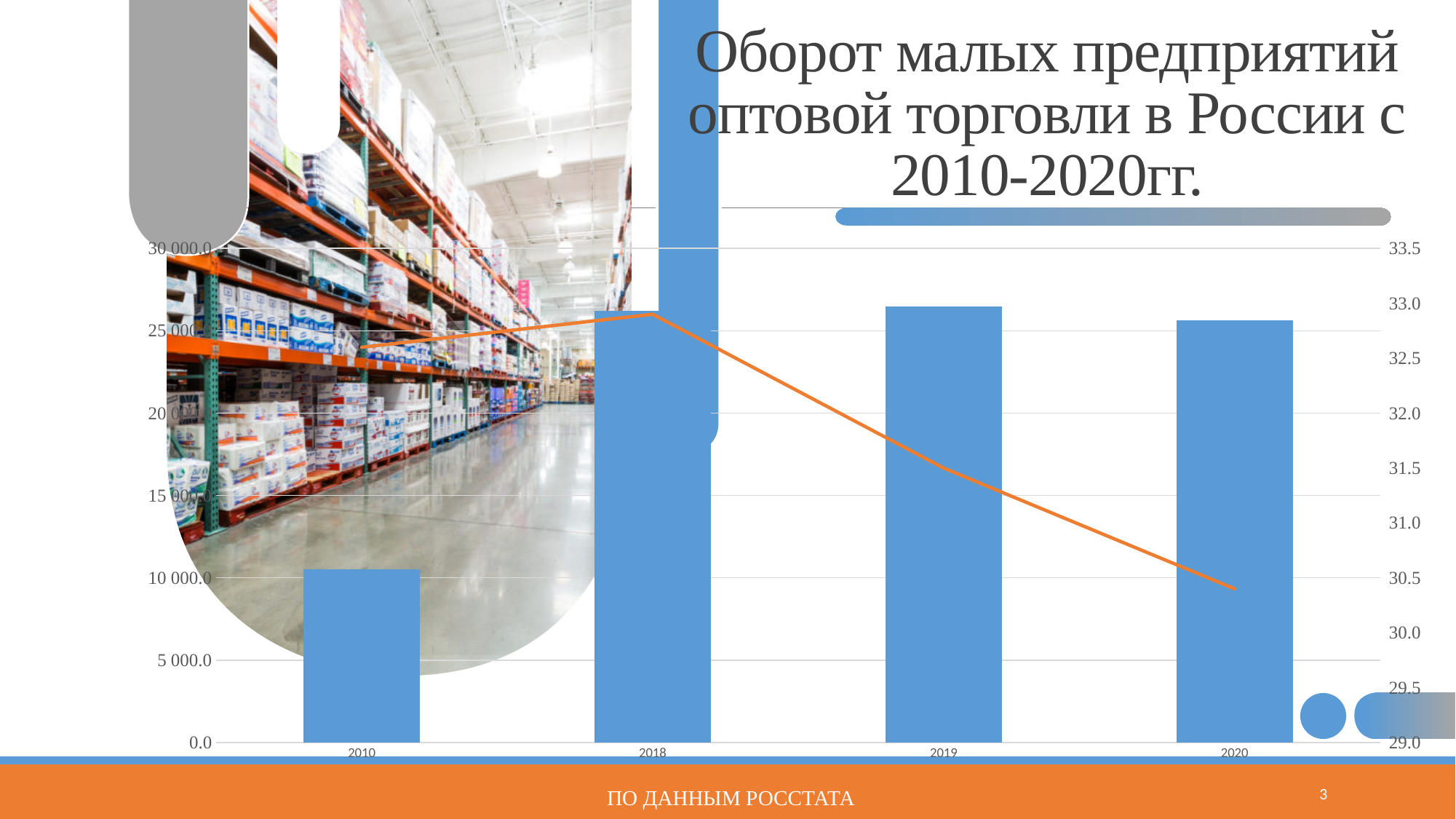
Is the orange line value for 2020 greater or less than 31.0 on the right axis? less How many years (categories) are shown on the x axis of the chart? 4 Is the bar value for 2010 greater or less than 15 000.0 on the left axis? less What is the title of the chart on the slide? Оборот малых предприятий оптовой торговли в России с 2010-2020гг. Is the bar value for 2020 greater or less than 30 000.0 on the left axis? less Does the orange line rise or fall from 2018 to 2020? It falls Which bar is taller, 2019 or 2020? 2019 Which year has the tallest bar in the chart? 2019 Which year has the shortest bar in the chart? 2010 At which year does the orange line reach its highest point? 2018 What kind of chart is shown on the slide? A bar chart combined with a line